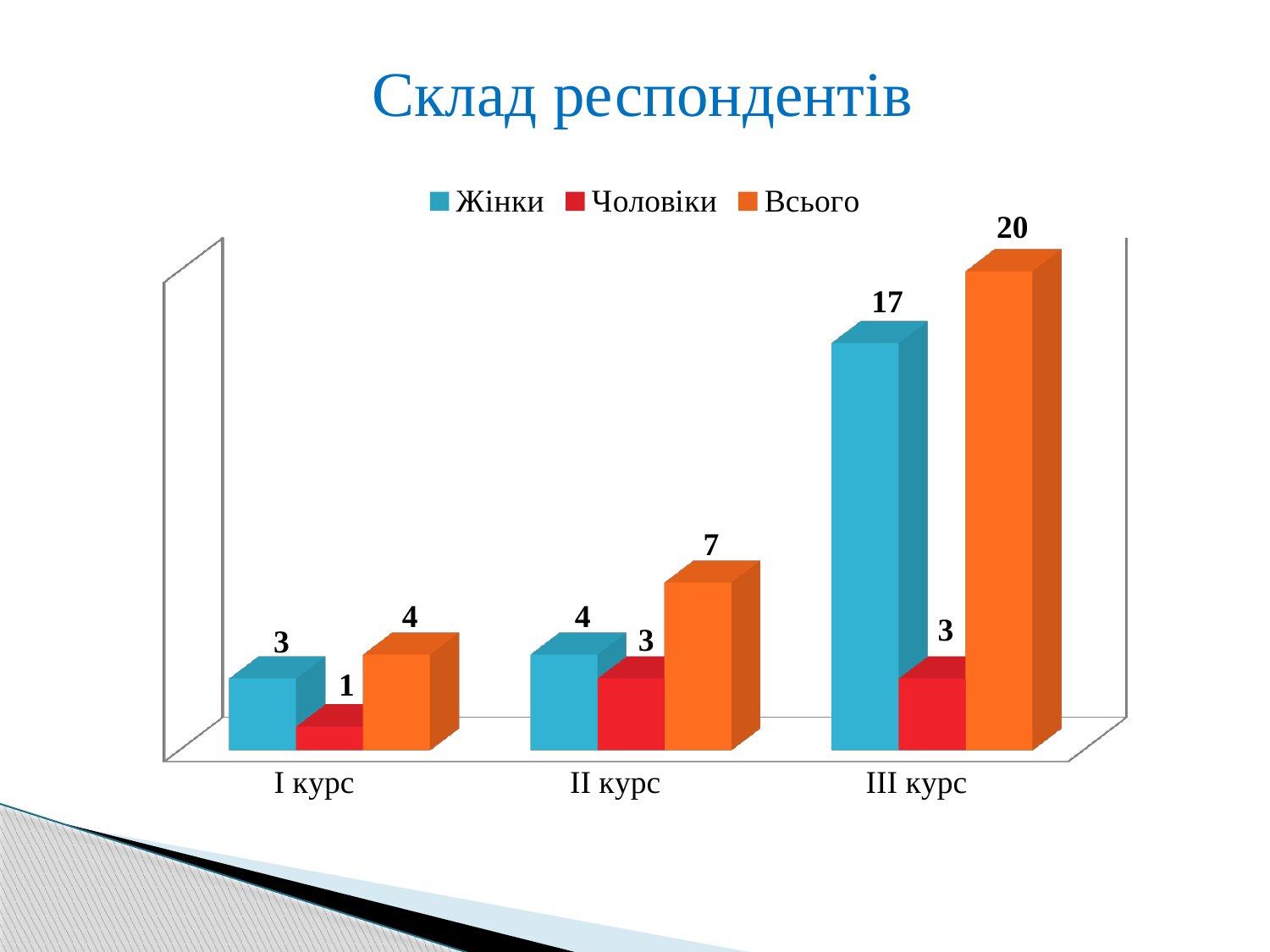
Do the values for Всього rise or fall from I курс to III курс? rise How many series does the legend list? 3 What is the difference between Жінки and Чоловіки in III курс? 14 What kind of chart is shown on the slide? bar chart Which is larger: Жінки in II курс or Чоловіки in II курс? Жінки in II курс Which category has the highest value for Всього? III курс What is the value for Всього in II курс? 7 What is the value for Жінки in III курс? 17 What is the difference between Всього for III курс and Всього for II курс? 13 What is the value for Чоловіки in I курс? 1 Which category has the lowest value for Чоловіки? I курс How many categories are shown on the x axis? 3